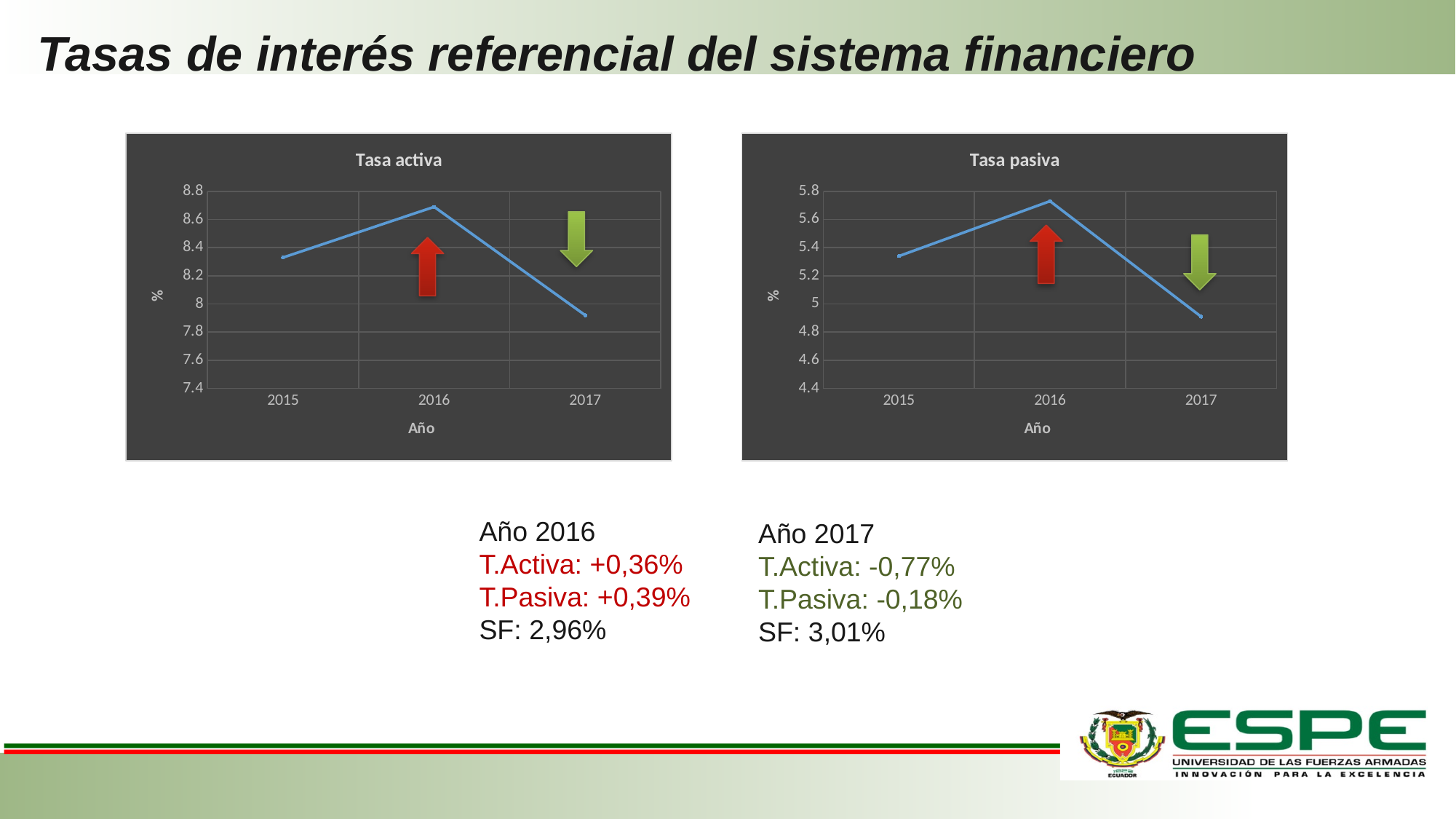
In the "Tasa activa" chart, is the value for 2017 greater or less than 8? less In the "Tasa pasiva" chart, how many years are plotted on the x axis? 3 In the "Tasa activa" chart, which year has the lowest value? 2017 In the "Tasa activa" chart, what kind of chart is shown? line chart In the "Tasa pasiva" chart, which year has the lowest value? 2017 In the "Tasa pasiva" chart, which year has the highest value? 2016 In the "Tasa activa" chart, does the value rise or fall from 2016 to 2017? fall In the "Tasa pasiva" chart, is the value for 2015 greater or less than 5.2? greater In the "Tasa pasiva" chart, is the value for 2017 greater or less than 5? less In the "Tasa activa" chart, which year has the highest value? 2016 In the "Tasa pasiva" chart, which is larger, the value for 2015 or the value for 2017? 2015